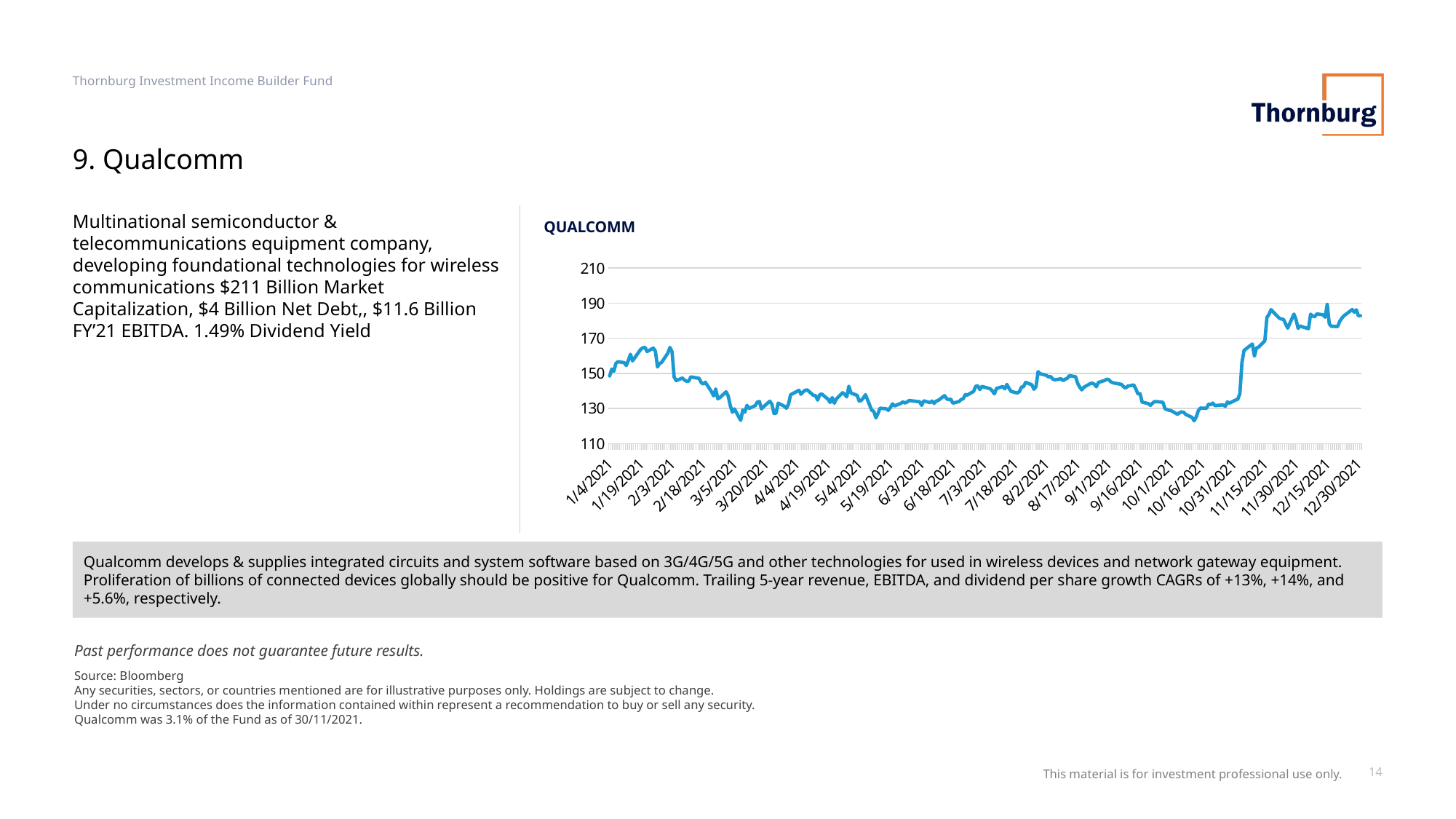
What kind of chart is shown on the slide? line chart Which is larger, the value at 10/16/2021 or the value at 11/15/2021? 11/15/2021 What is the highest value shown on the chart's vertical axis? 210 What is the title of the chart? QUALCOMM Is the value at 11/30/2021 greater or less than 170? greater Is the value at 1/4/2021 greater or less than 130? greater Which is larger, the value at 1/4/2021 or the value at 12/30/2021? 12/30/2021 Overall, does the line rise or fall from the start of 2021 to the end of 2021? rise Is the value at 3/5/2021 greater or less than 150? less